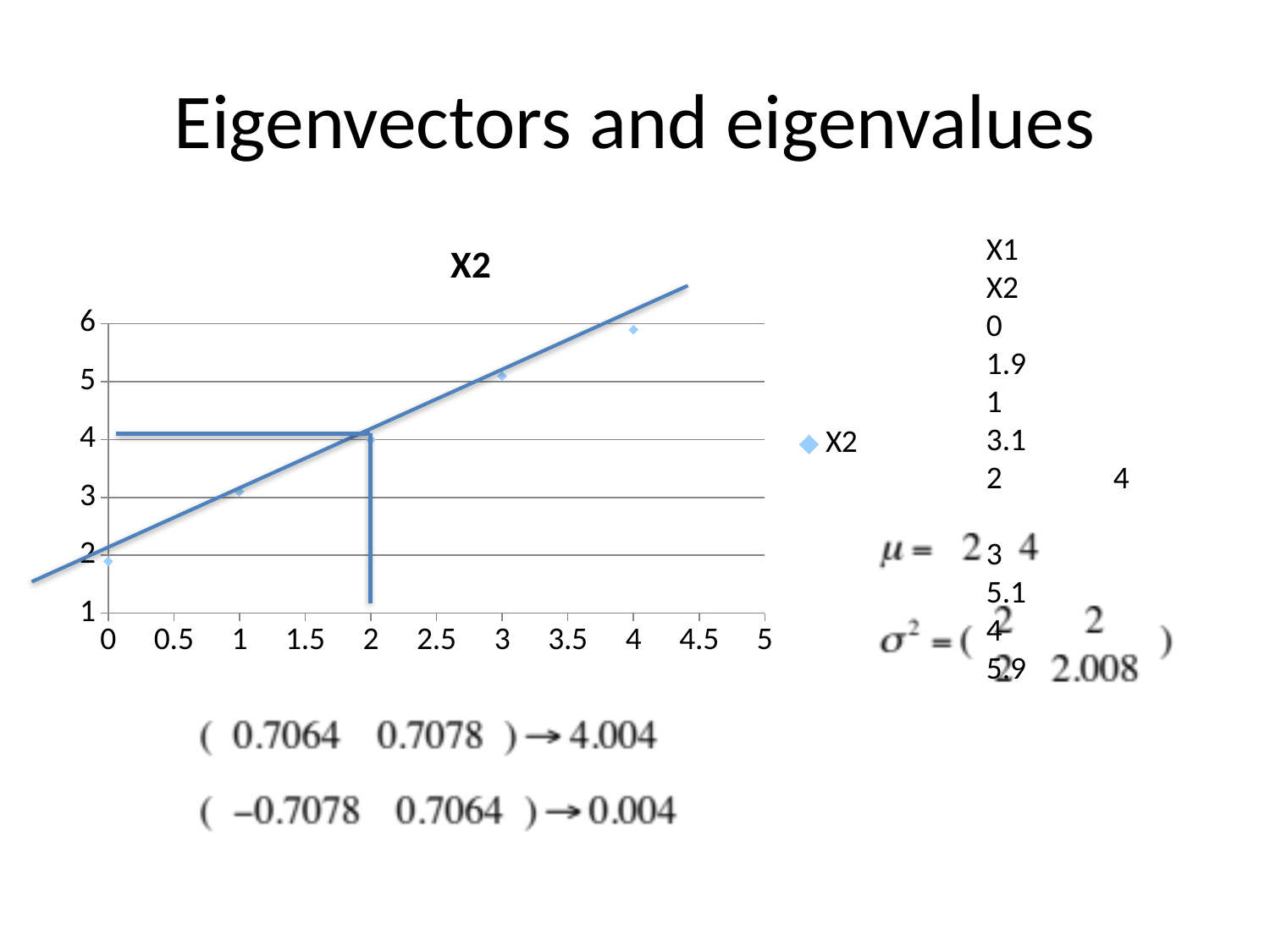
How many series does the chart legend list? 1 What is the title of the chart? X2 At which x value is the X2 value highest? 4 What kind of chart is shown on the slide? scatter chart Is the X2 value at x = 4 greater or less than 5? greater How many data points are plotted in the X2 chart? 5 What is the X2 value at x = 2? 4 Do the X2 values rise or fall as the x axis increases? rise At which x value is the X2 value lowest? 0